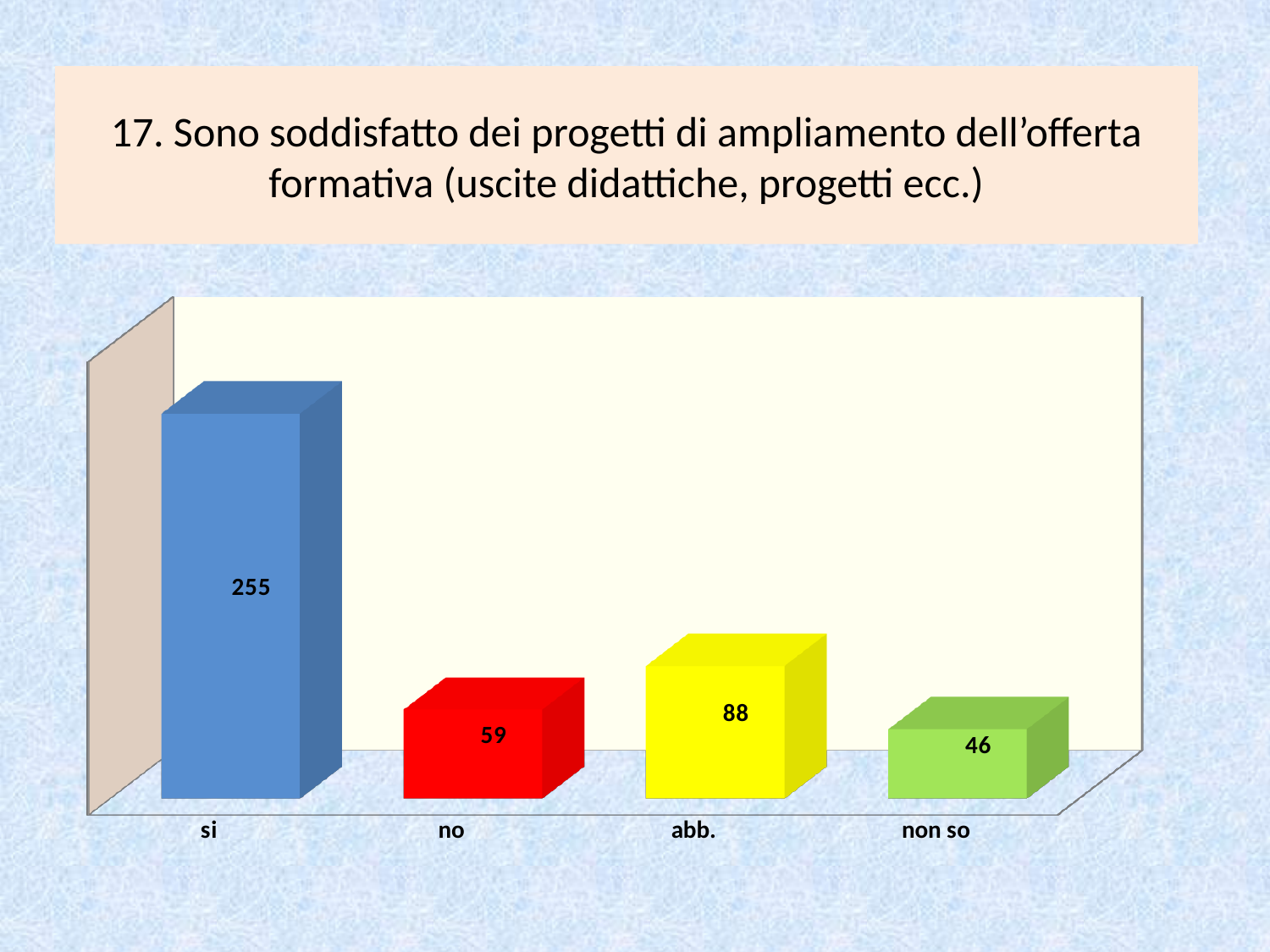
Which is larger, the value for "abb." or the value for "no"? abb. How many categories are shown on the x axis? 4 What is the value for "abb."? 88 What is the value for "si"? 255 What is the difference between the values for "no" and "non so"? 13 What is the difference between the values for "si" and "abb."? 167 Which category has the lowest value? non so Which category has the highest value? si What kind of chart is shown on the slide? bar chart What colour is the bar for "abb."? yellow What is the value for "no"? 59 What is the value for "non so"? 46